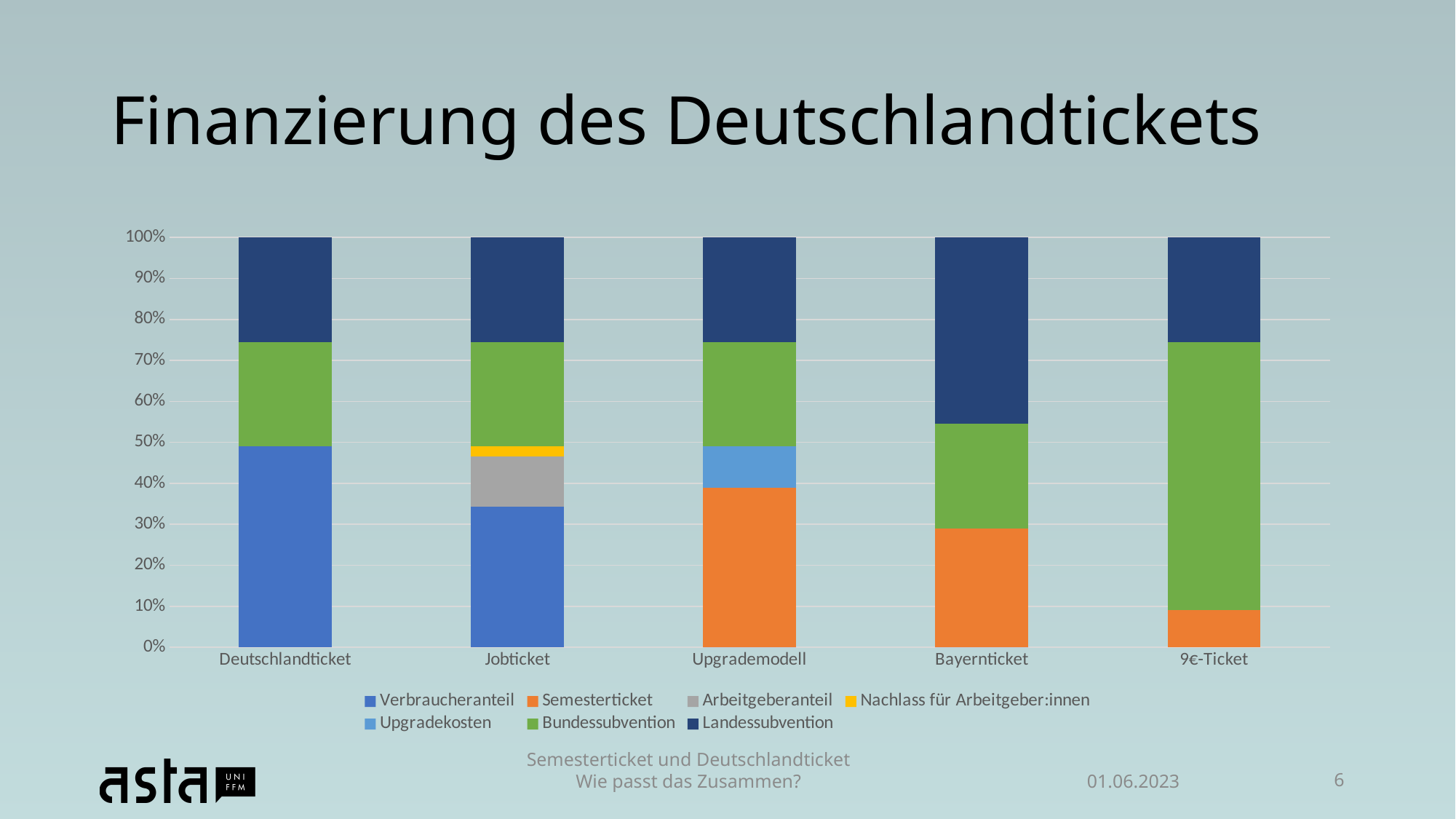
Which category has the largest Bundessubvention share? 9€-Ticket Which has the larger Semesterticket share, Upgrademodell or 9€-Ticket? Upgrademodell Is the Semesterticket share for Upgrademodell greater or less than 30%? greater What kind of chart is shown on the slide? stacked bar chart Which category is the only one that includes an Arbeitgeberanteil segment? Jobticket Is the Bundessubvention share for 9€-Ticket greater or less than 60%? greater Which category has the largest Landessubvention share? Bayernticket Which has the larger Landessubvention share, Bayernticket or Deutschlandticket? Bayernticket What is the title of the chart slide? Finanzierung des Deutschlandtickets Is the Verbraucheranteil share for Jobticket greater or less than 40%? less How many series does the legend list? 7 How many ticket models (categories) are shown on the x axis? 5